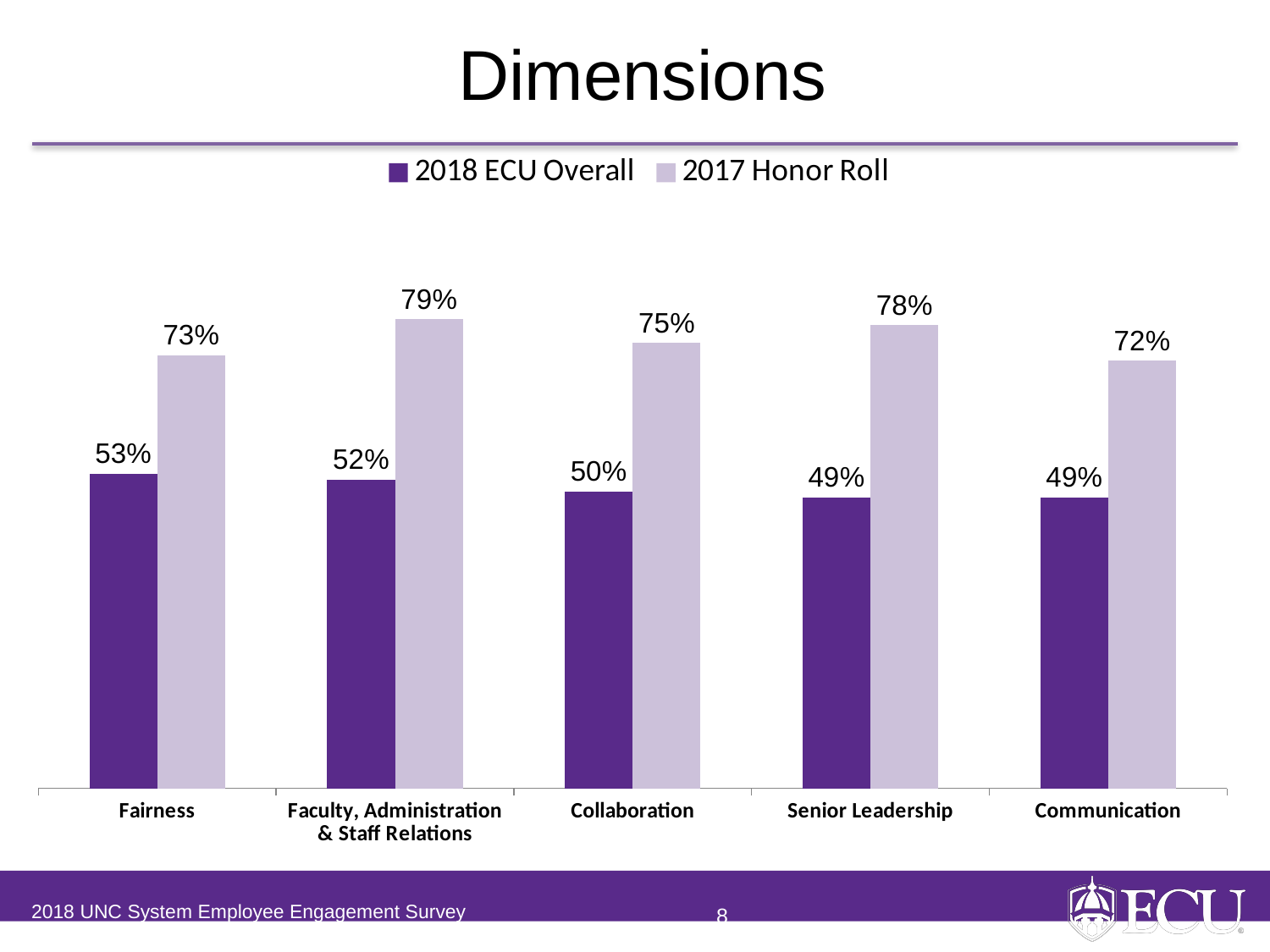
What is the difference between the 2017 Honor Roll and 2018 ECU Overall values for Senior Leadership? 29% Which is larger: the 2018 ECU Overall value for Collaboration or for Communication? Collaboration Which category has the highest 2018 ECU Overall value? Fairness What is the 2018 ECU Overall value for Fairness? 53% Which category has the highest 2017 Honor Roll value? Faculty, Administration & Staff Relations How many categories are shown on the x axis? 5 What is the 2018 ECU Overall value for Senior Leadership? 49% What is the 2017 Honor Roll value for Collaboration? 75% Which category has the lowest 2017 Honor Roll value? Communication How many series does the legend list? 2 What kind of chart is shown on the slide? Bar chart What is the difference between the 2017 Honor Roll and 2018 ECU Overall values for Fairness? 20%